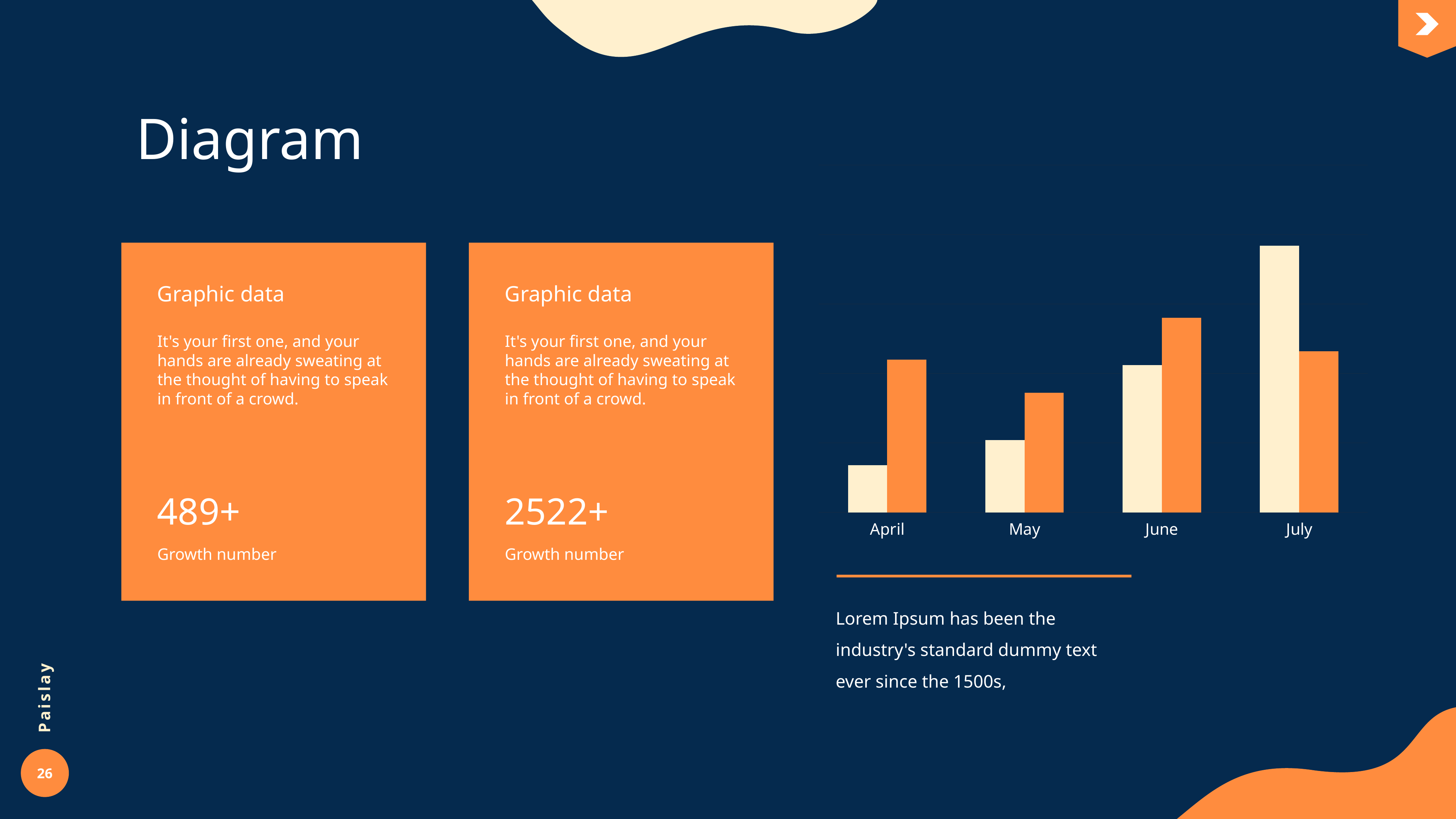
In July, which bar is taller, the cream-coloured one or the orange one? cream In April, which bar is taller, the cream-coloured one or the orange one? orange Do the cream-coloured bars rise or fall from April to July? rise Which month has the tallest cream-coloured bar in the bar chart? July Which month has the tallest orange bar in the bar chart? June What are the category labels on the x axis of the bar chart, from left to right? April, May, June, July How many categories are shown on the x axis of the bar chart? 4 Which month has the shortest orange bar in the bar chart? May Which month has the shortest cream-coloured bar in the bar chart? April What kind of chart is shown on the right side of the slide? bar chart How many bars are drawn for each month in the bar chart? 2